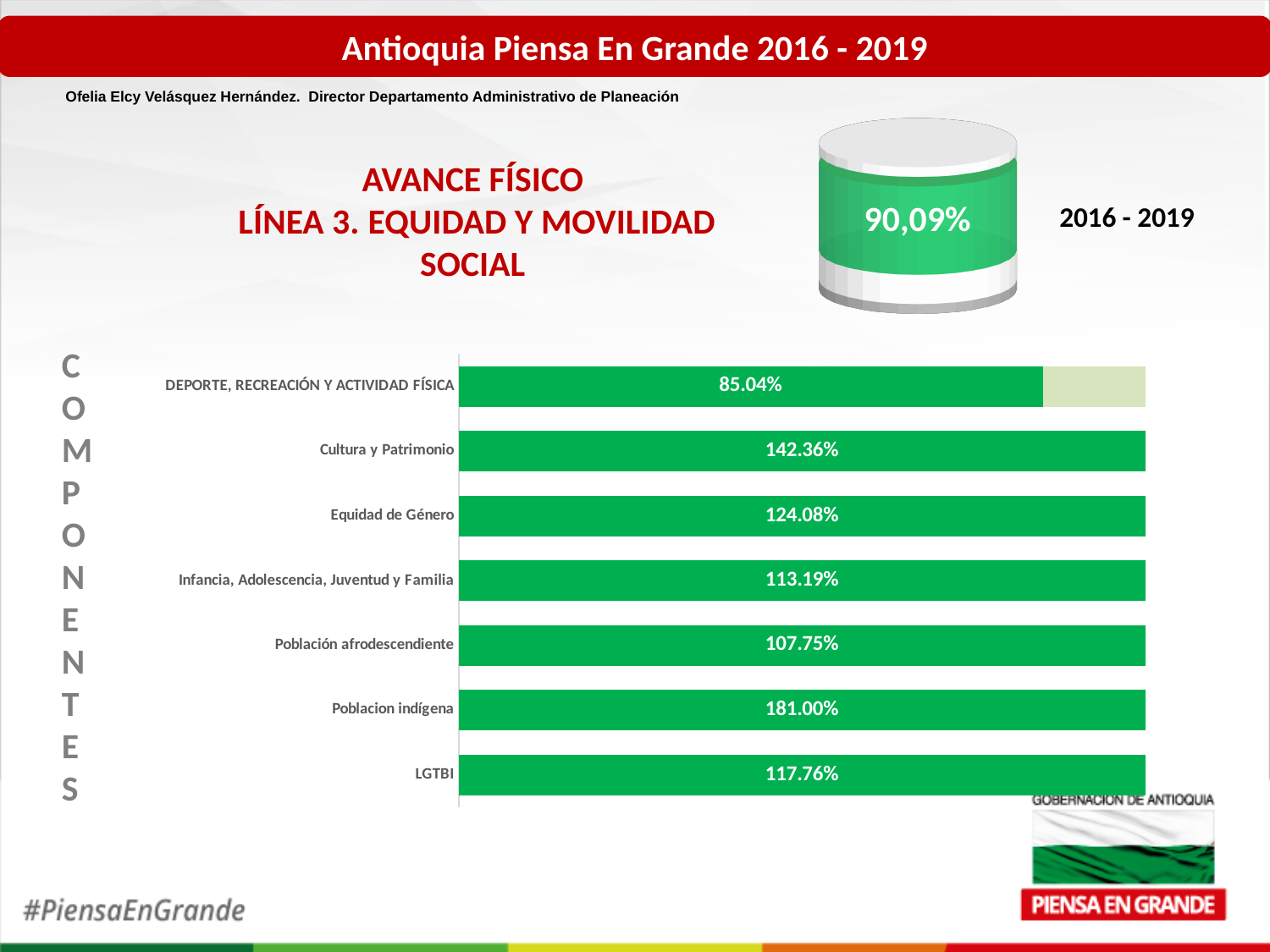
What is the difference between the values for Cultura y Patrimonio and Equidad de Género? 18.28% What is the value shown for LGTBI? 117.76% What is the difference between the values for Poblacion indígena and DEPORTE, RECREACIÓN Y ACTIVIDAD FÍSICA? 95.96% What is the value shown for DEPORTE, RECREACIÓN Y ACTIVIDAD FÍSICA? 85.04% Which component has the lowest value in the chart? DEPORTE, RECREACIÓN Y ACTIVIDAD FÍSICA What kind of chart is shown on the slide? bar chart Which component has the highest value in the chart? Poblacion indígena How many components (categories) are plotted in the bar chart? 7 Which has a larger value, Infancia, Adolescencia, Juventud y Familia or LGTBI? LGTBI What overall physical progress percentage is shown in the cylinder graphic above the chart? 90,09% What is the value shown for Cultura y Patrimonio? 142.36% What is the value shown for Población afrodescendiente? 107.75%